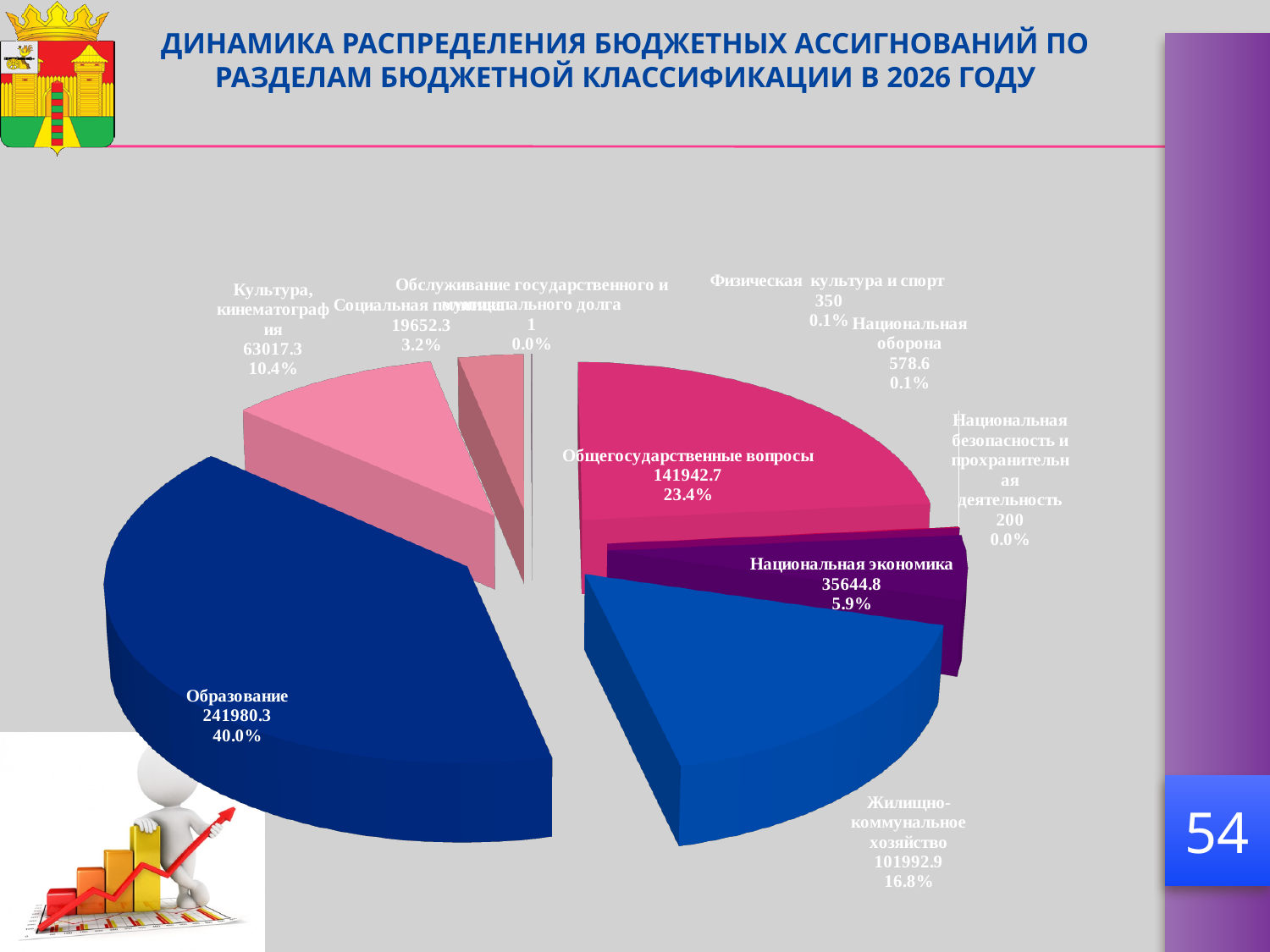
What kind of chart is shown on the slide? Pie chart Which is larger: the value for Жилищно-коммунальное хозяйство or the value for Национальная экономика? Жилищно-коммунальное хозяйство Which section has the smallest value in the pie chart? Обслуживание государственного и муниципального долга What is the value shown for Национальная оборона? 578.6 What is the value shown for Общегосударственные вопросы? 141942.7 Which section has the largest share of budget allocations in the pie chart? Образование What is the difference between the values for Образование and Общегосударственные вопросы? 100037.6 How many sections are shown in the pie chart? 10 What is the value shown for Жилищно-коммунальное хозяйство? 101992.9 What percentage is shown for Национальная экономика? 5.9% What is the value shown for Культура, кинематография? 63017.3 What share of the pie does Образование account for? 40.0%